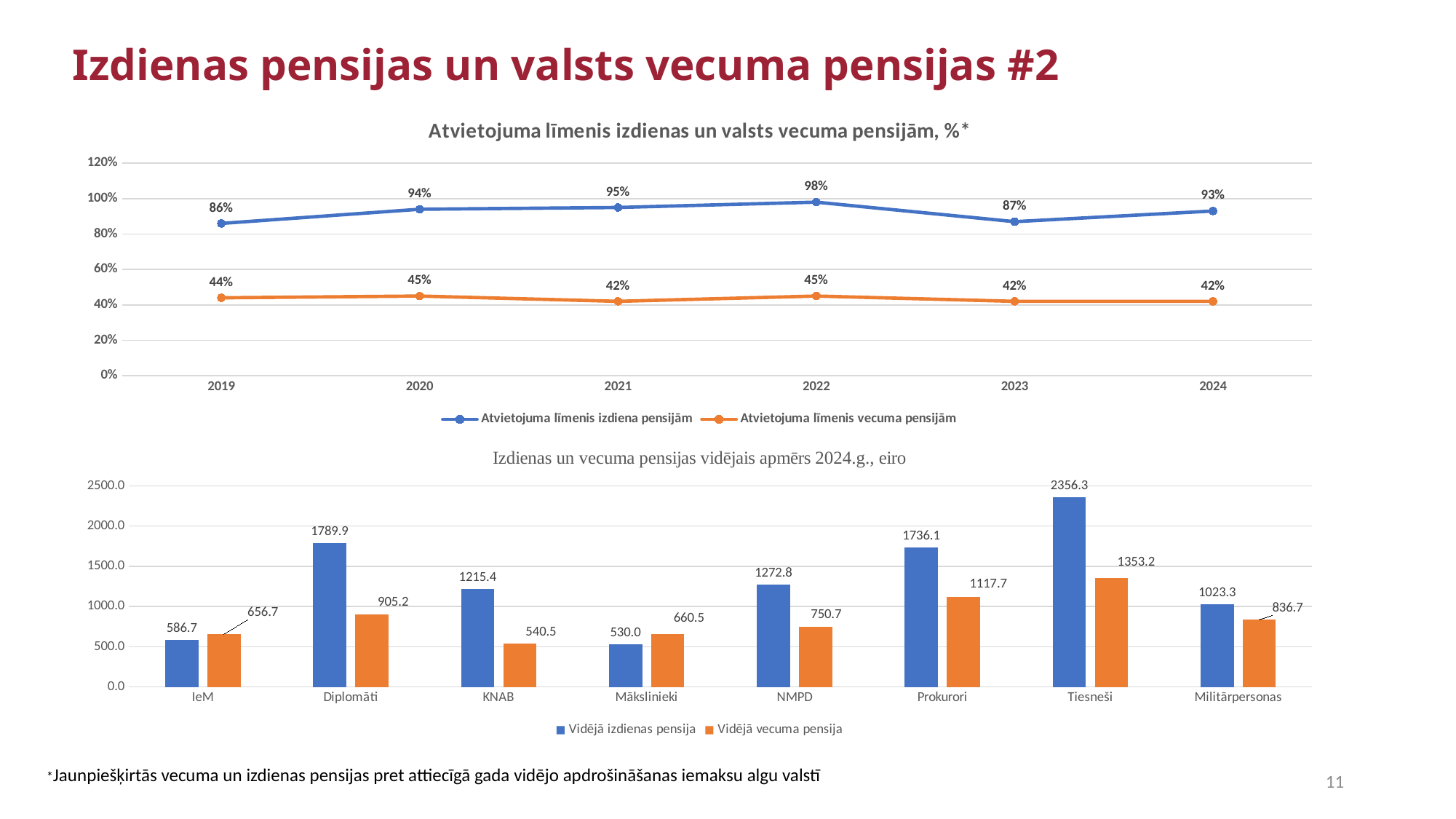
In the top chart 'Atvietojuma līmenis izdienas un valsts vecuma pensijām, %*', what is the value for 'Atvietojuma līmenis vecuma pensijām' in 2019? 44% In the bottom chart 'Izdienas un vecuma pensijas vidējais apmērs 2024.g., eiro', which category has the lowest 'Vidējā izdienas pensija'? Mākslinieki In the bottom chart 'Izdienas un vecuma pensijas vidējais apmērs 2024.g., eiro', how many categories are shown on the x axis? 8 In the top chart 'Atvietojuma līmenis izdienas un valsts vecuma pensijām, %*', how many series does the legend list? 2 In the bottom chart 'Izdienas un vecuma pensijas vidējais apmērs 2024.g., eiro', what is the difference between 'Vidējā izdienas pensija' and 'Vidējā vecuma pensija' for Diplomāti? 884.7 What kind of chart is the top chart 'Atvietojuma līmenis izdienas un valsts vecuma pensijām, %*'? Line chart In the bottom chart 'Izdienas un vecuma pensijas vidējais apmērs 2024.g., eiro', what is the value of 'Vidējā vecuma pensija' for KNAB? 540.5 In the bottom chart 'Izdienas un vecuma pensijas vidējais apmērs 2024.g., eiro', what is the value of 'Vidējā izdienas pensija' for Tiesneši? 2356.3 In the top chart 'Atvietojuma līmenis izdienas un valsts vecuma pensijām, %*', which year has the lowest value for 'Atvietojuma līmenis izdiena pensijām'? 2019 In the top chart 'Atvietojuma līmenis izdienas un valsts vecuma pensijām, %*', what is the value for 'Atvietojuma līmenis izdiena pensijām' in 2022? 98% In the top chart 'Atvietojuma līmenis izdienas un valsts vecuma pensijām, %*', what is the difference between the two series in 2024? 51 percentage points What kind of chart is the bottom chart 'Izdienas un vecuma pensijas vidējais apmērs 2024.g., eiro'? Bar chart